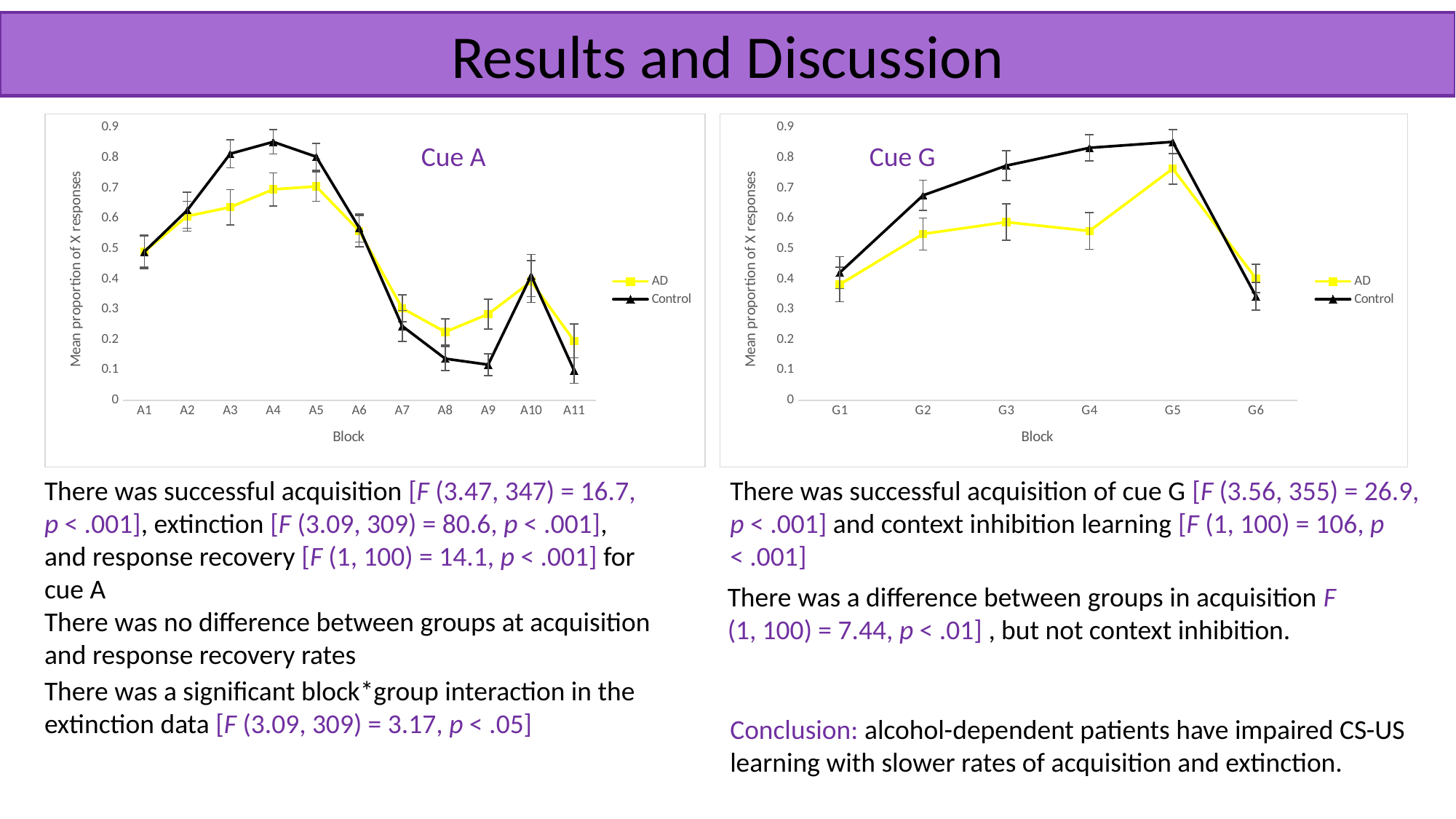
In the Cue A chart, which series has the larger value at A8, AD or Control? AD In the Cue A chart, is the AD value at A8 greater or less than 0.3? less In the Cue A chart, is the Control value at A4 greater or less than 0.8? greater What type of chart is the Cue A chart? line chart How many blocks are plotted on the x axis of the Cue A chart? 11 How many series does the legend of the Cue G chart list? 2 In the Cue G chart, at which block is the Control series lowest? G6 In the Cue G chart, at which block does the AD series reach its highest value? G5 In the Cue A chart, at which block does the Control series reach its highest value? A4 In the Cue G chart, does the Control series rise or fall from G1 to G5? rise In the Cue G chart, is the Control value at G6 greater or less than 0.4? less How many blocks are plotted on the x axis of the Cue G chart? 6